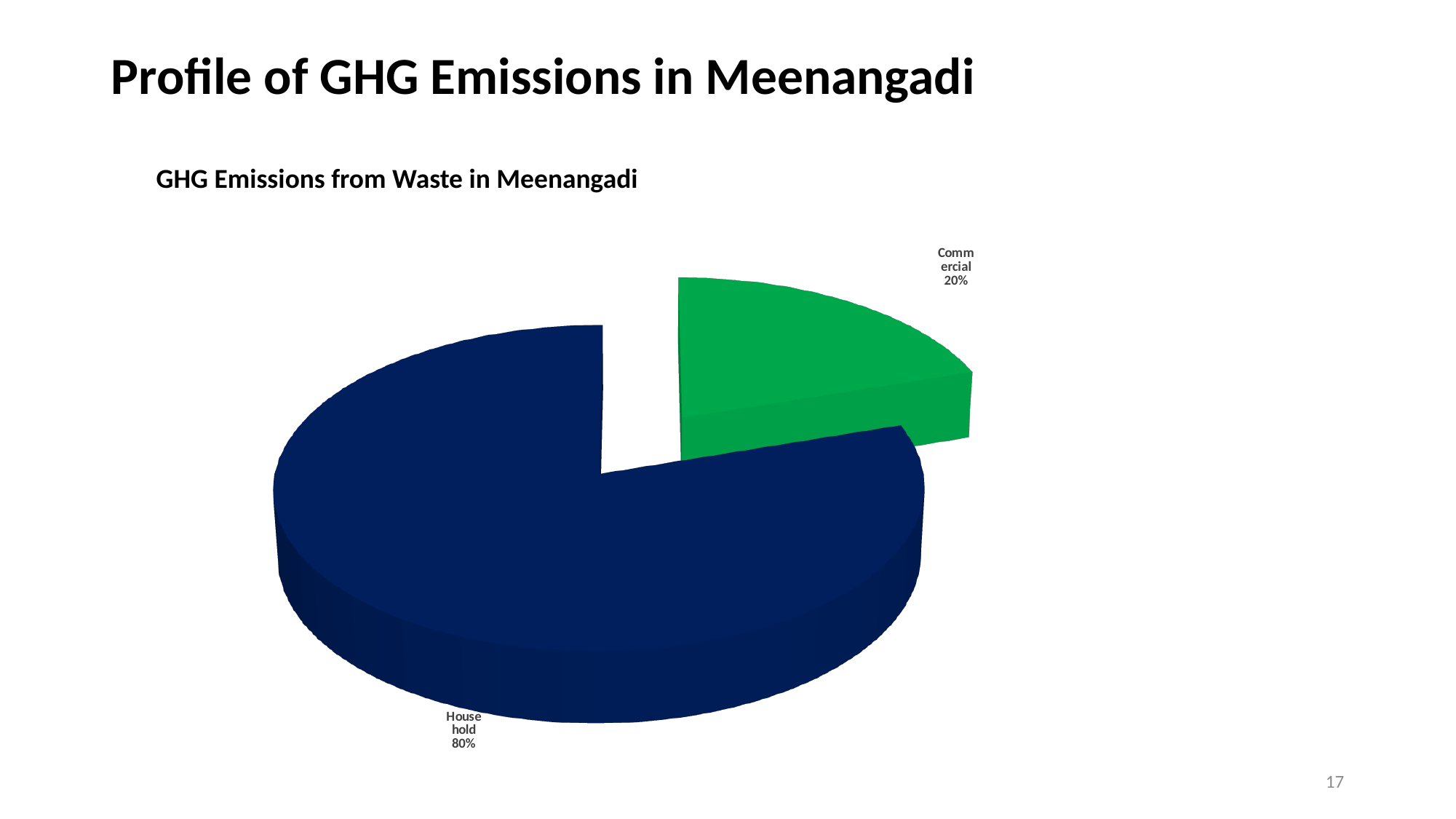
What share of GHG emissions from waste comes from Commercial? 20% What colour is the Commercial slice? Green What is the title of the chart? GHG Emissions from Waste in Meenangadi Which is larger, the Household share or the Commercial share? Household How many slices does the pie chart have? 2 What kind of chart is shown on the slide? Pie chart What share of GHG emissions from waste comes from Household? 80% What is the difference in percentage points between the Household and Commercial shares? 60% Which category has the smallest share of the pie? Commercial Which category has the largest share of the pie? Household